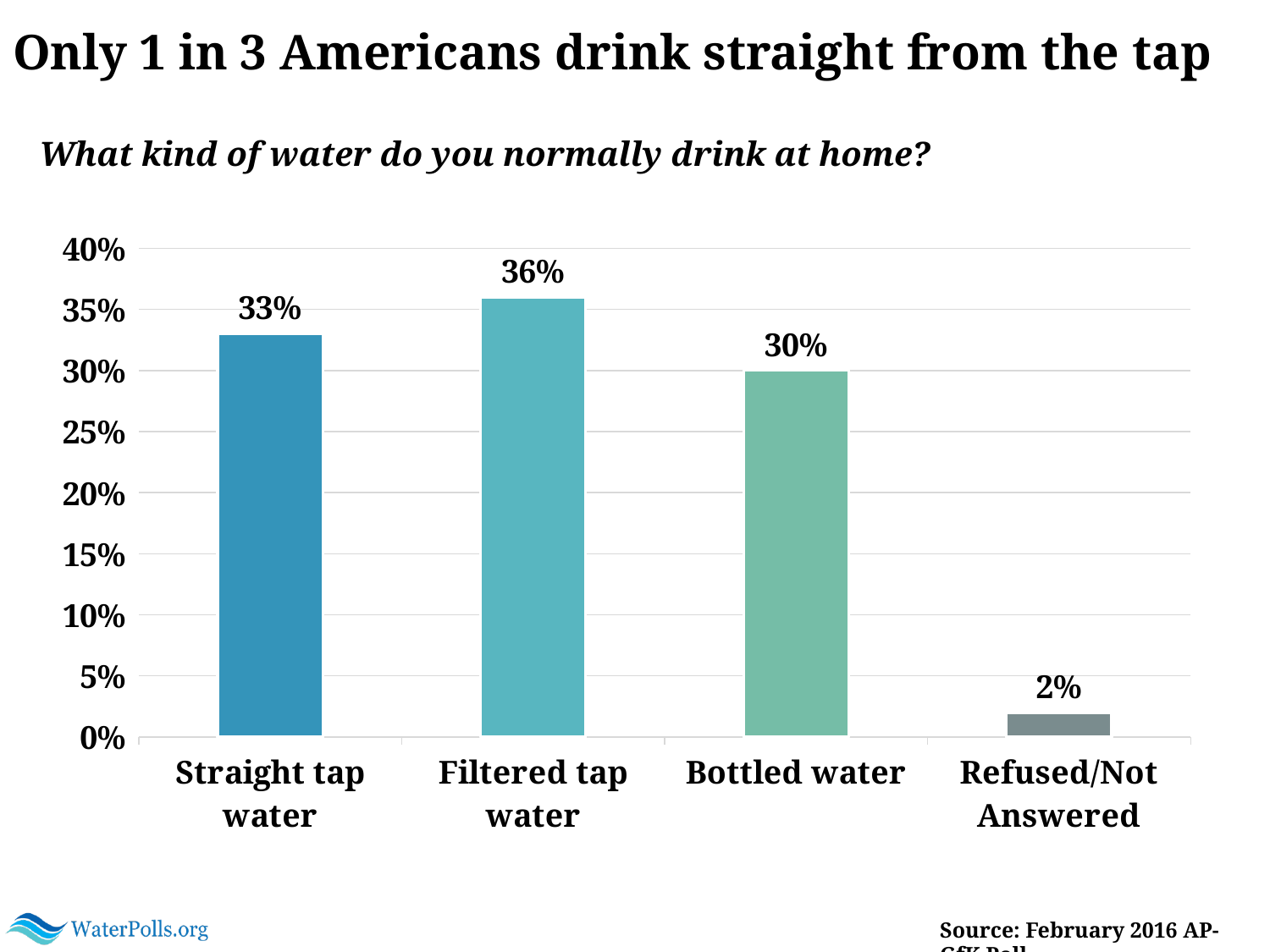
What question is the chart based on, as shown in the subtitle? What kind of water do you normally drink at home? What is the difference between the values for Straight tap water and Refused/Not Answered? 31% What percentage of respondents normally drink straight tap water at home? 33% Which category has the highest value? Filtered tap water What kind of chart is shown on the slide? Bar chart What is the value shown for Refused/Not Answered? 2% What percentage of respondents normally drink bottled water at home? 30% What is the value shown for Filtered tap water? 36% Which category has the lowest value? Refused/Not Answered Which is larger, the value for Straight tap water or the value for Bottled water? Straight tap water How many categories are shown on the x axis? 4 What is the difference between the values for Filtered tap water and Bottled water? 6%